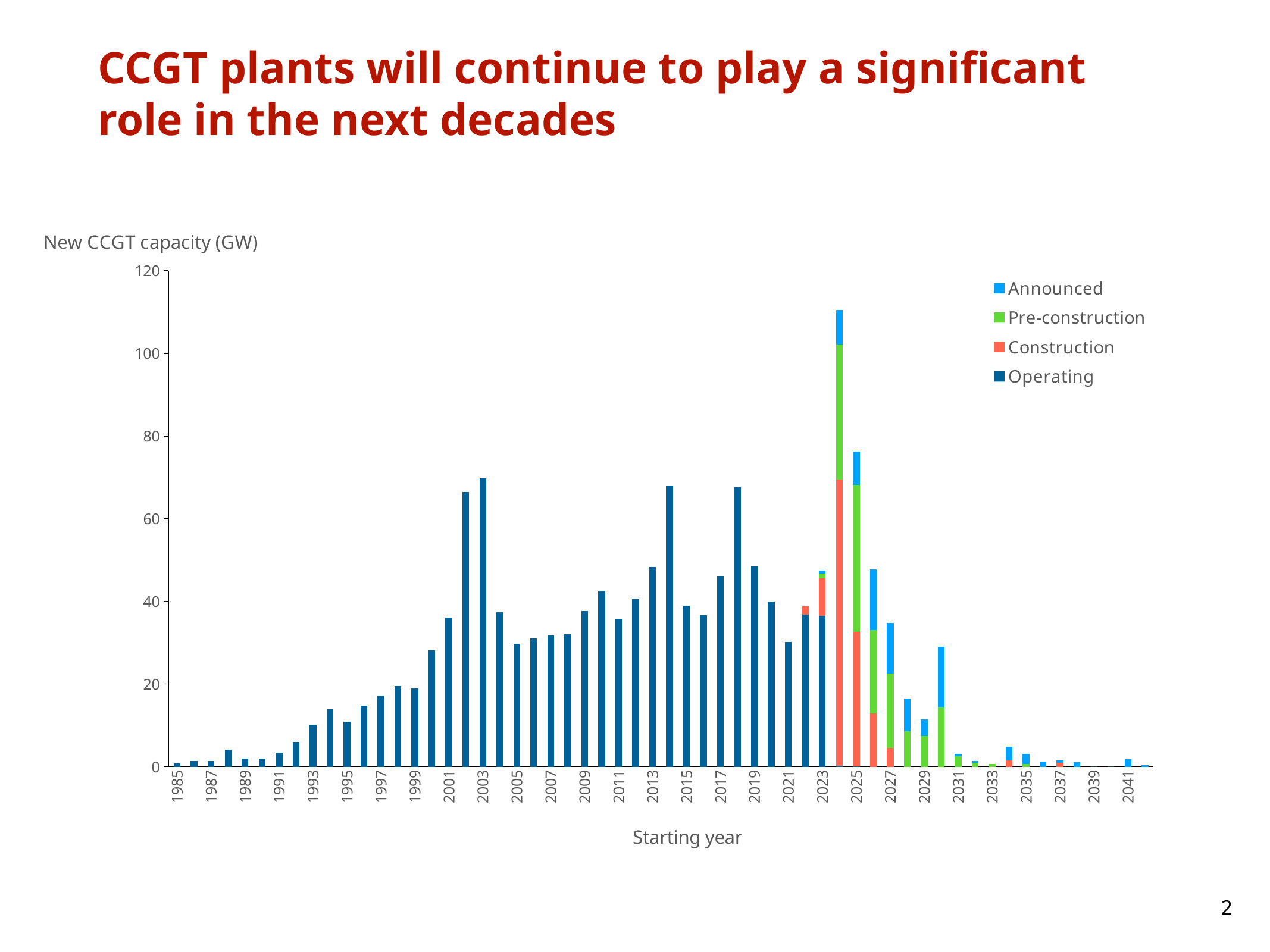
Is the value for 2003 greater or less than 60? greater Which has the larger total new CCGT capacity, 2024 or 2025? 2024 Which has the larger value, 2003 or 1993? 2003 Which starting year has the highest total new CCGT capacity? 2024 How many series does the legend list? 4 Is the total value for 2025 greater or less than 60? greater What kind of chart is shown on the slide? Stacked bar chart Is the total value for 2024 greater or less than 100? greater Do the values generally rise or fall from 1985 to 2003? rise What is the label of the x axis? Starting year